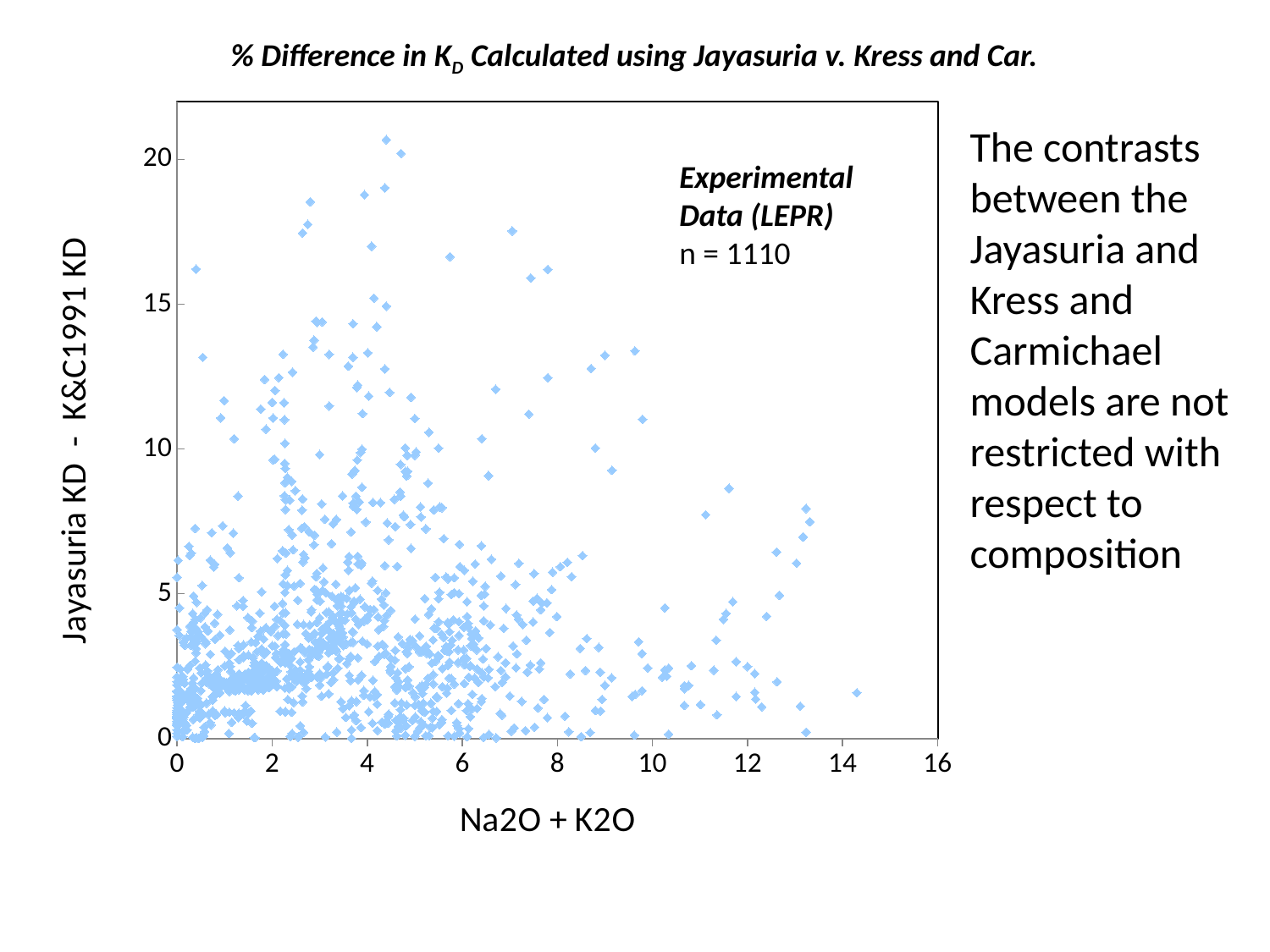
Is the largest x value plotted on the chart greater or less than 12? greater Is the y value of the point with the largest x value (near 14 on the x axis) greater or less than 5? less Are there any points plotted with an x value greater than 16? No What is the label of the x axis of the chart? Na2O + K2O How many experimental data points does the chart state it contains (n)? 1110 What kind of chart is shown on the slide? scatter plot What data source is named in the annotation inside the plot area? Experimental Data (LEPR)